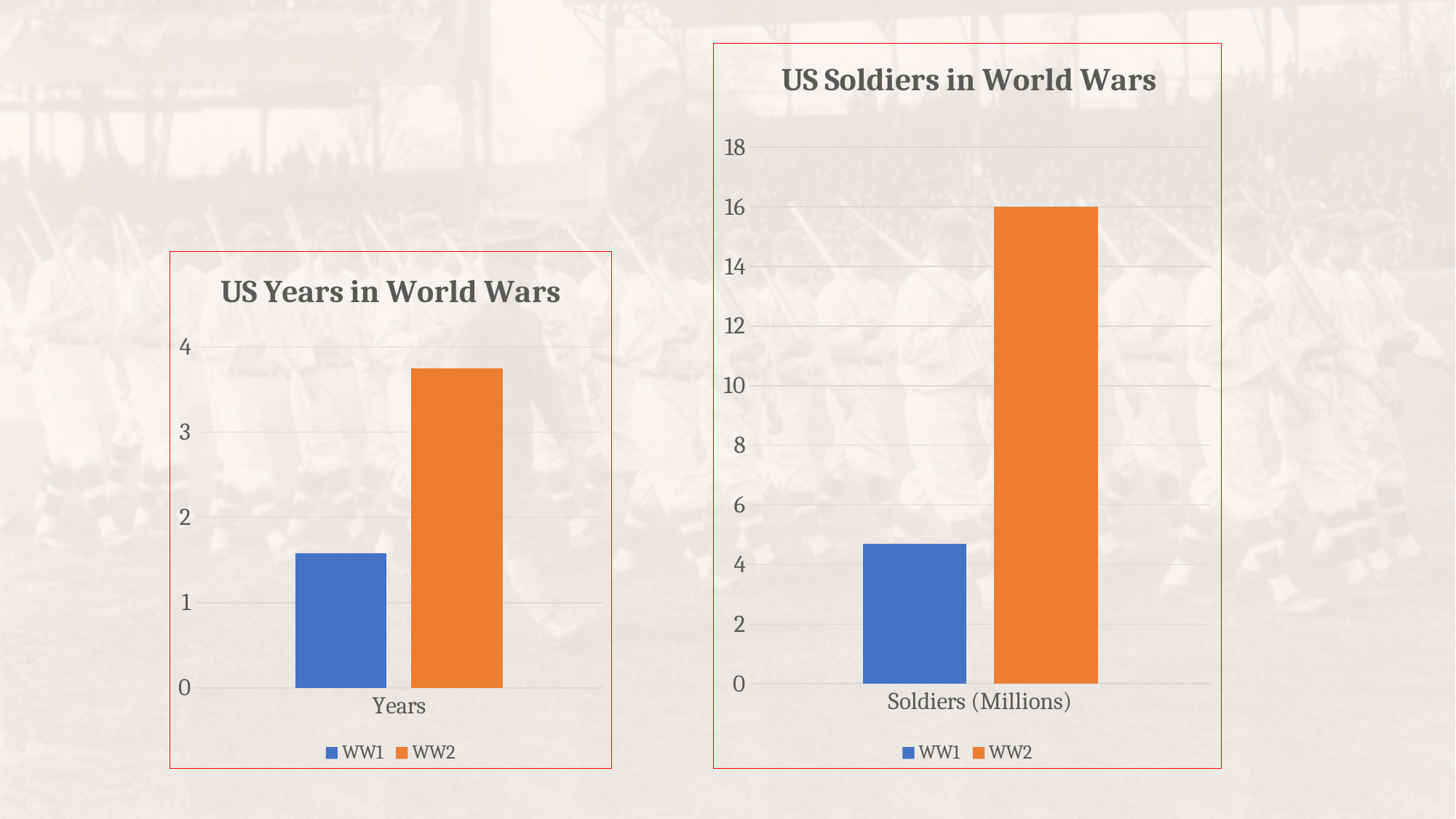
What kind of chart is the 'US Years in World Wars' chart? bar chart In the 'US Soldiers in World Wars' chart, is the value for WW1 greater or less than 4? greater How many charts are shown on the slide? 2 How many series does the legend of the 'US Soldiers in World Wars' chart list? 2 In the 'US Years in World Wars' chart, is the value for WW2 greater or less than 3? greater What is the x-axis category label on the 'US Soldiers in World Wars' chart? Soldiers (Millions) In the 'US Soldiers in World Wars' chart, which series has the lowest value? WW1 In the 'US Years in World Wars' chart, which series has the higher value, WW1 or WW2? WW2 In the 'US Soldiers in World Wars' chart, what is the value for WW2? 16 In the 'US Years in World Wars' chart, is the value for WW1 greater or less than 2? less What colour are the WW2 bars on the slide's charts? orange